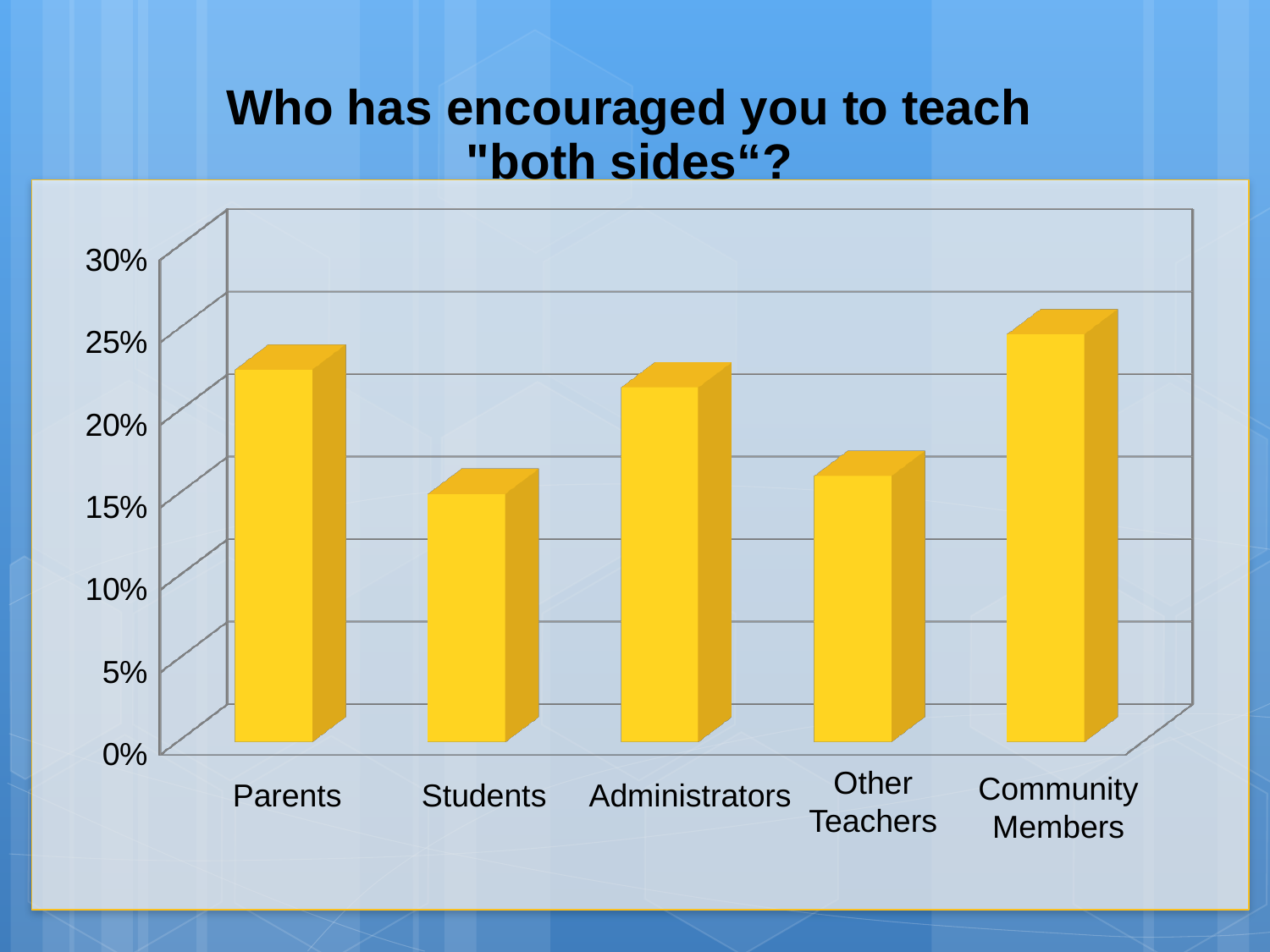
What kind of chart is shown on the slide? bar chart How many categories are shown on the x axis of the chart? 5 Is the value for Students greater or less than 20%? less Which category has the highest value in the chart? Community Members Which is larger, the value for Community Members or the value for Other Teachers? Community Members What is the highest value shown on the y axis of the chart? 30% Which is larger, the value for Parents or the value for Students? Parents Is the value for Administrators greater or less than 15%? greater Is the value for Other Teachers greater or less than 20%? less What is the title of the chart on the slide? Who has encouraged you to teach "both sides"?